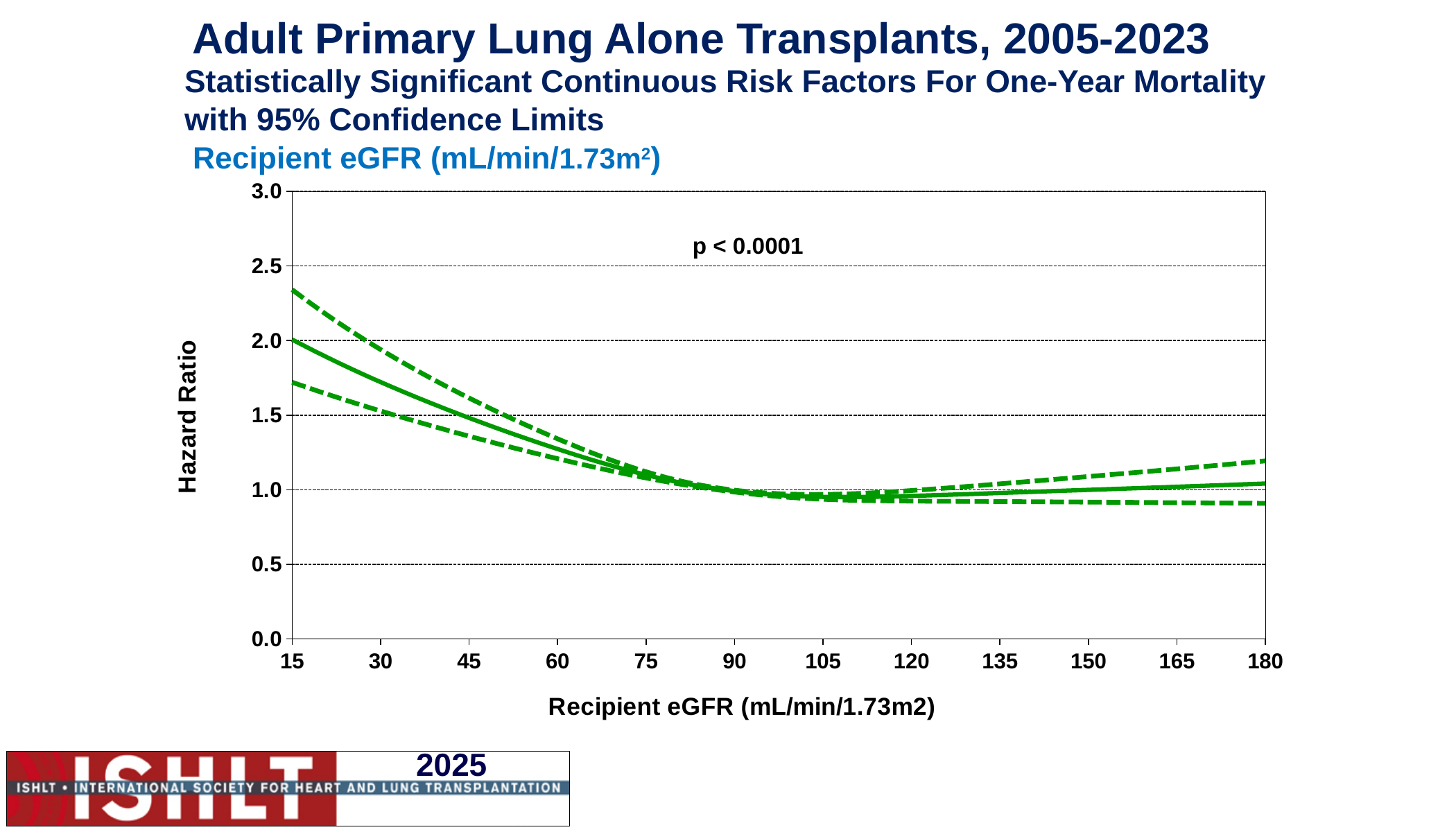
Is the upper dashed confidence limit at a recipient eGFR of 15 greater or less than 2.0? greater Is the hazard ratio on the solid line at a recipient eGFR of 15 greater or less than 1.5? greater What kind of chart is shown on the slide? line chart How many lines are plotted on the chart? 3 Does the hazard ratio (solid line) rise or fall as recipient eGFR increases from 15 to 90? fall What is the p-value printed on the chart? p < 0.0001 What is the label of the y axis? Hazard Ratio Is the hazard ratio on the solid line at a recipient eGFR of 30 greater or less than 1.5? greater What is the highest value shown on the y axis? 3.0 Is the hazard ratio on the solid line higher at a recipient eGFR of 15 or at 180? 15